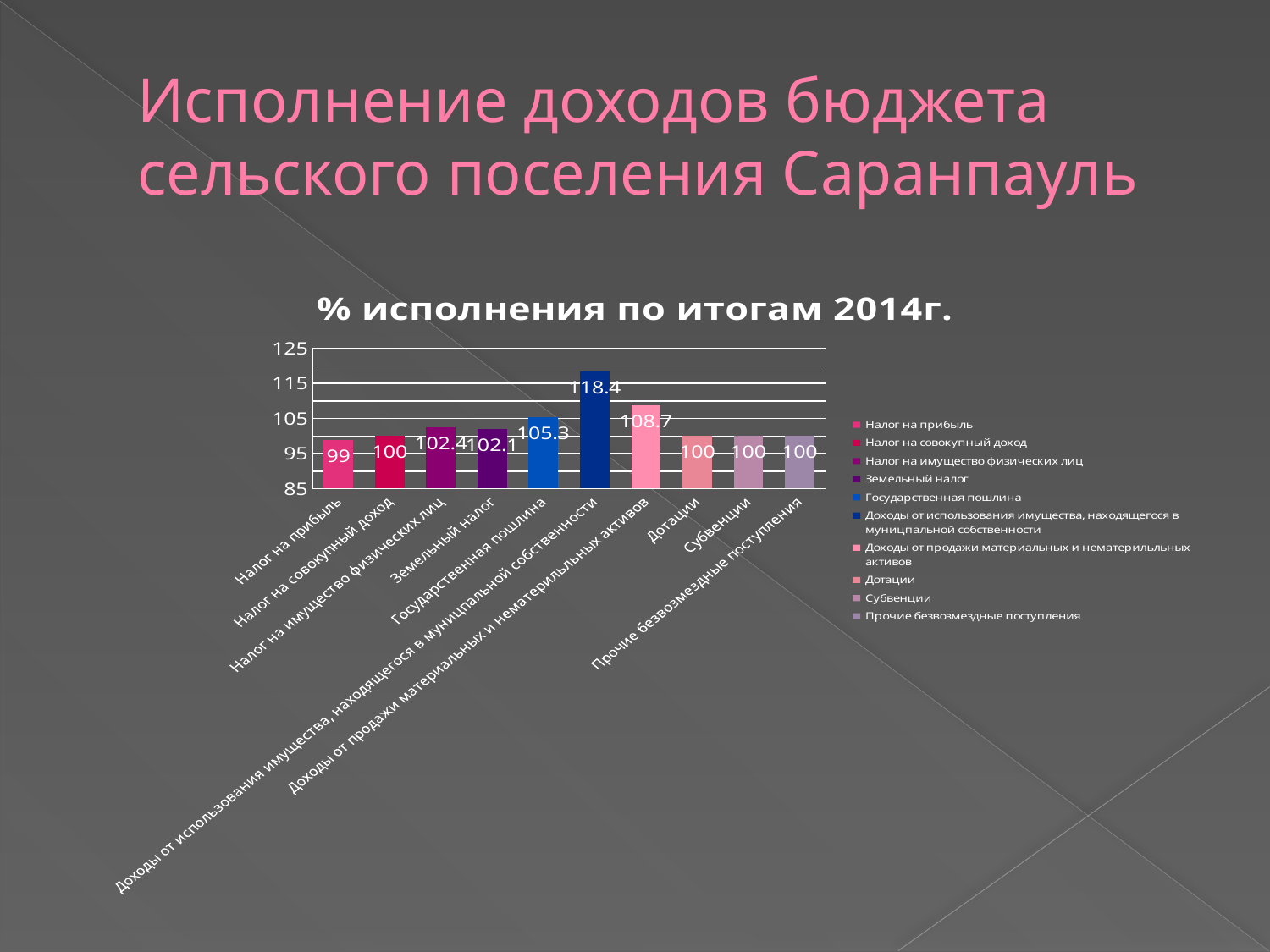
Which category has the highest value? Доходы от использования имущества, находящегося в муниципальной собственности What is the title of the chart? % исполнения по итогам 2014г. How many entries does the legend list? 10 What is the value for Государственная пошлина? 105.3 What is the value for Доходы от продажи материальных и нематериальных активов? 108.7 What is the value for Налог на прибыль? 99 What is the difference between the values for Доходы от использования имущества, находящегося в муниципальной собственности and Доходы от продажи материальных и нематериальных активов? 9.7 Which category has the lowest value? Налог на прибыль How many categories are plotted in the chart? 10 What is the value for Налог на имущество физических лиц? 102.4 Which is larger, the value for Земельный налог or the value for Государственная пошлина? Государственная пошлина What type of chart is shown on the slide? Bar chart